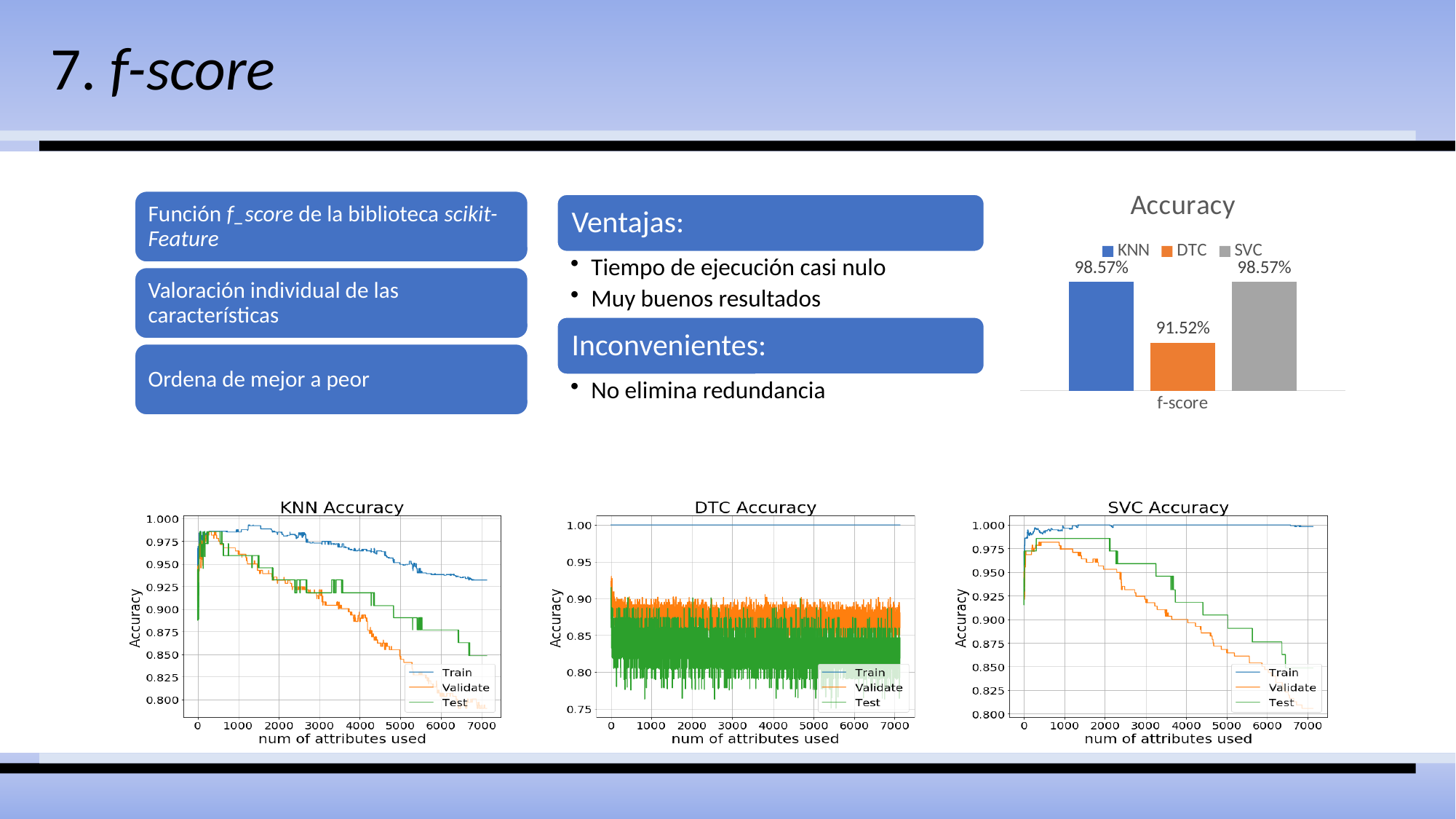
What is the category label on the x axis of the Accuracy bar chart? f-score How many series does the legend of the Accuracy bar chart list? 3 In the SVC Accuracy chart, does the Validate line rise or fall as the number of attributes used increases beyond 1000? Fall In the Accuracy bar chart, what is the difference between the KNN and DTC values? 7.05% How many series does the legend of the SVC Accuracy chart list? 3 In the Accuracy bar chart, which classifier has the lowest accuracy? DTC In the Accuracy bar chart, what is the value for KNN? 98.57% What kind of chart is the Accuracy chart at the top right of the slide? Bar chart What kind of chart is the KNN Accuracy chart? Line chart In the DTC Accuracy chart, at what value does the Train line stay across the whole x axis? 1.00 In the Accuracy bar chart, which is larger, the value for SVC or the value for DTC? SVC In the Accuracy bar chart, what is the value for DTC? 91.52%